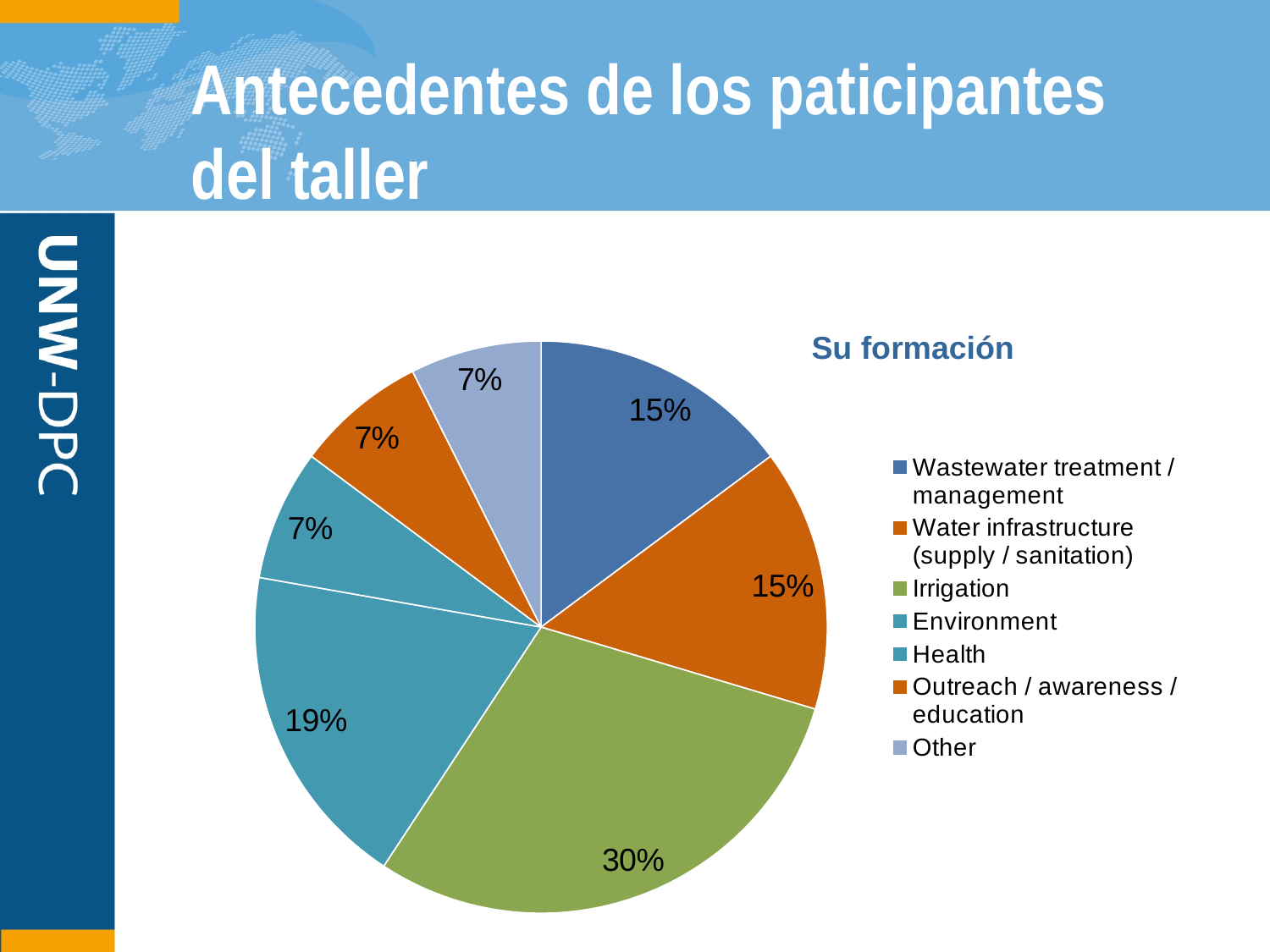
What is the title of the chart? Su formación What share of the pie does Irrigation represent? 30% What share of the pie does Environment represent? 19% How many categories does the legend list? 7 What is the value for Health? 7% What is the value for Wastewater treatment / management? 15% What type of chart is shown on the slide? pie chart What is the combined share of Wastewater treatment / management and Water infrastructure (supply / sanitation)? 30% What is the difference between the Irrigation share and the Environment share? 11% Which category has the largest slice of the pie? Irrigation What is the value for Other? 7% Which is larger, the slice for Environment or the slice for Water infrastructure (supply / sanitation)? Environment